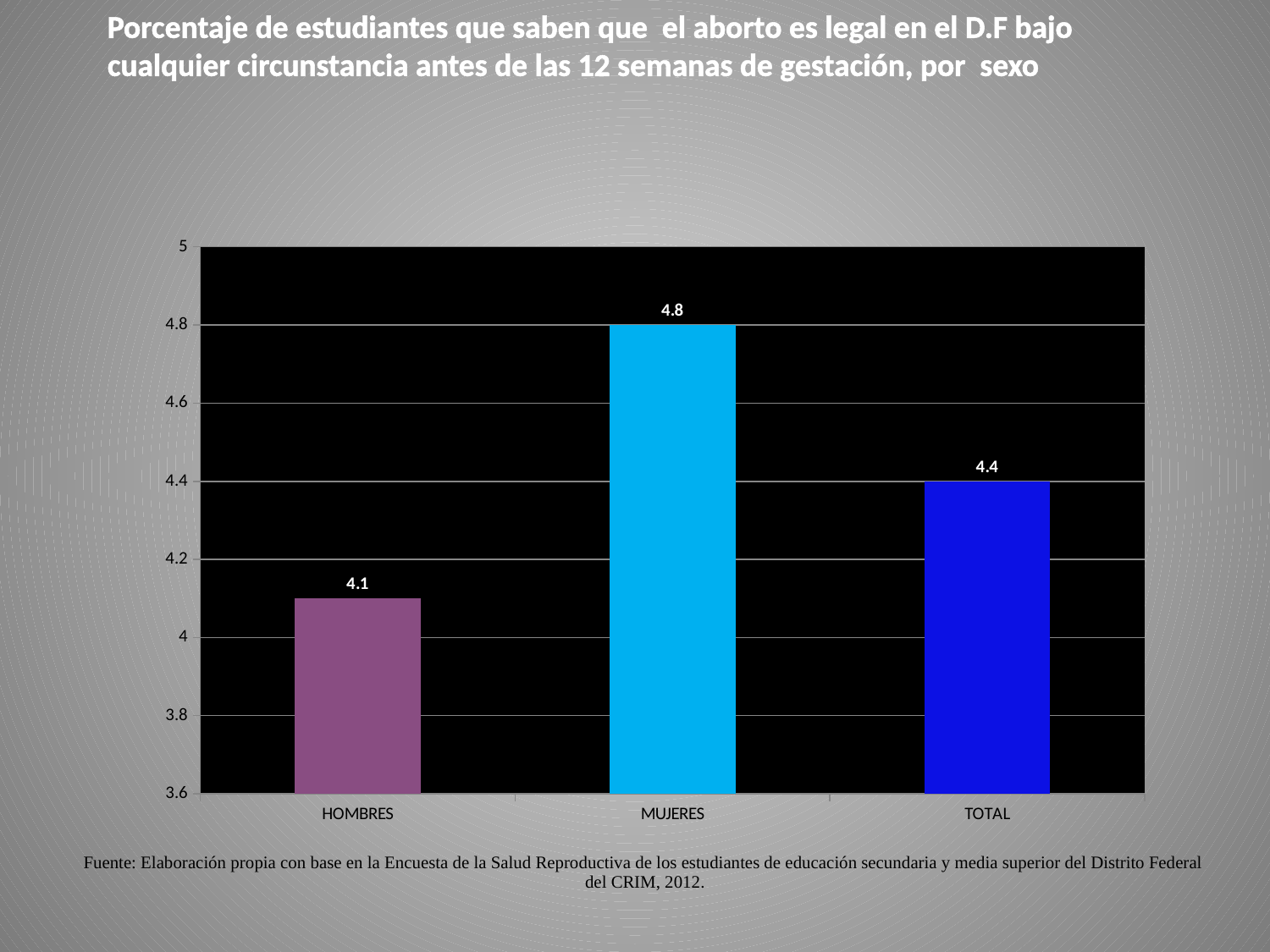
Which is larger, the value for HOMBRES or the value for TOTAL? TOTAL What is the value for MUJERES? 4.8 Which category has the lowest value? HOMBRES Which category has the highest value? MUJERES Is the value for MUJERES greater or less than 4.6? greater How many categories are shown on the x axis? 3 What kind of chart is shown on the slide? bar chart What is the difference between the values for MUJERES and HOMBRES? 0.7 What colour is the bar for MUJERES? light blue What is the value for HOMBRES? 4.1 What is the difference between the values for TOTAL and HOMBRES? 0.3 What is the value for TOTAL? 4.4